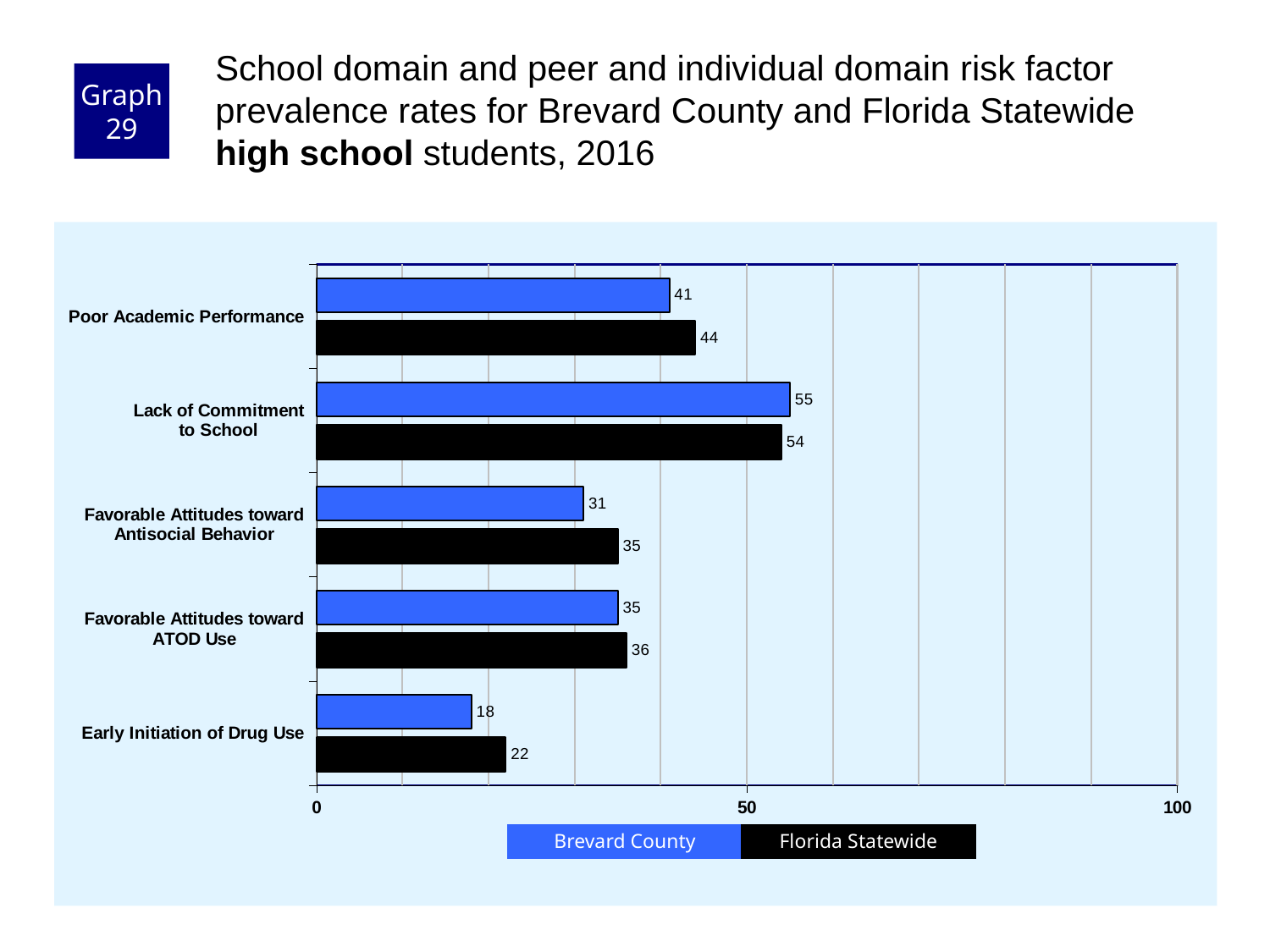
For Early Initiation of Drug Use, which is larger: the Brevard County value or the Florida Statewide value? Florida Statewide What is the Florida Statewide value for Lack of Commitment to School? 54 Which risk factor has the lowest Florida Statewide value? Early Initiation of Drug Use What is the difference between the Florida Statewide and Brevard County values for Favorable Attitudes toward Antisocial Behavior? 4 Which risk factor has the highest Brevard County value? Lack of Commitment to School What is the Florida Statewide value for Early Initiation of Drug Use? 22 What kind of chart is shown on the slide? bar chart How many risk factor categories are shown on the chart? 5 Which colour represents Florida Statewide in the chart? black How many series does the legend list? 2 Is the Brevard County value for Lack of Commitment to School greater or less than 50? greater What is the Brevard County value for Poor Academic Performance? 41